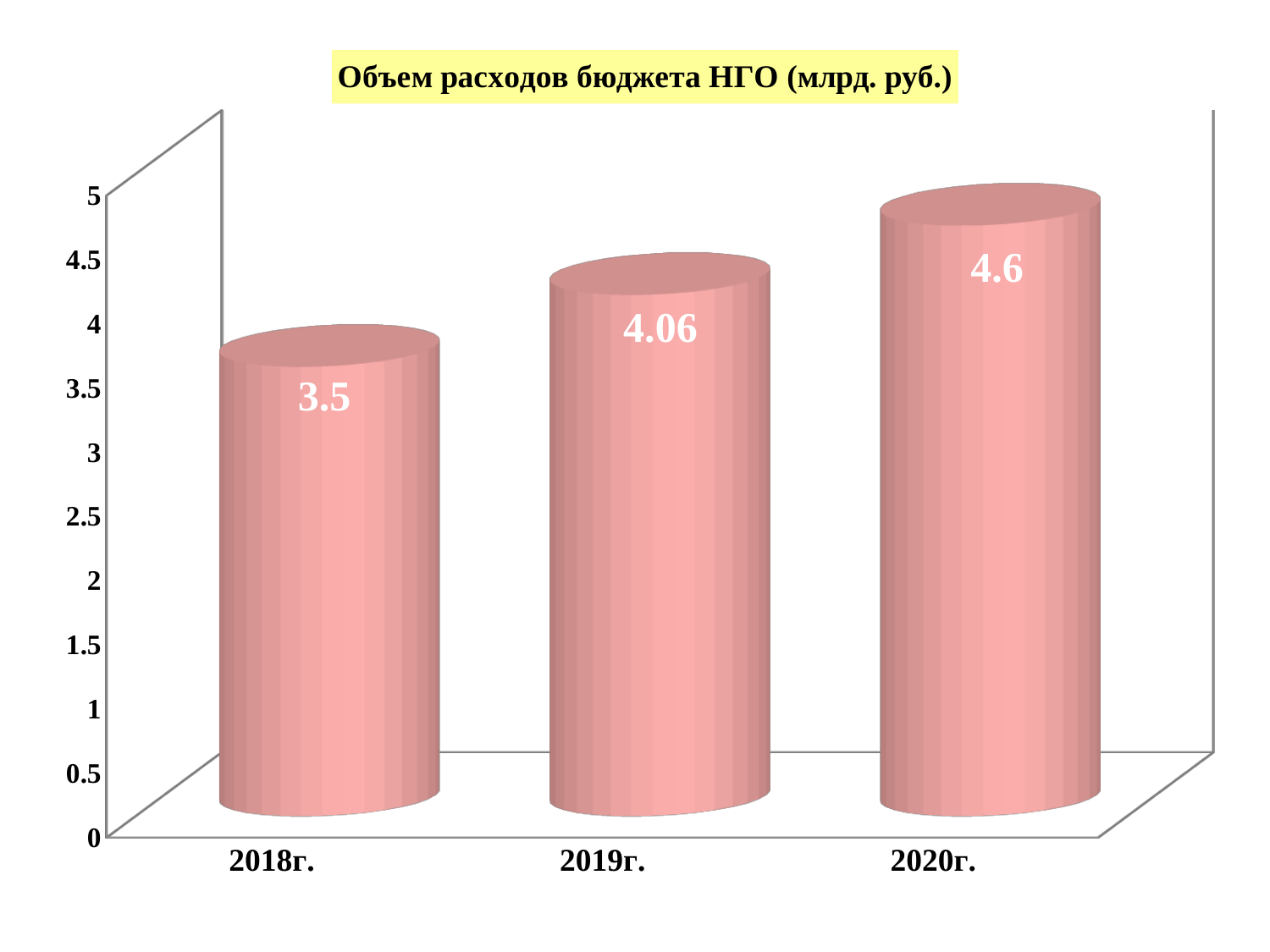
What is the value for 2018г.? 3.5 Is the value for 2018г. greater or less than 4? less What is the value for 2019г.? 4.06 How many years are shown on the chart? 3 Which is larger, the value for 2019г. or the value for 2020г.? 2020г. Which year has the highest value? 2020г. What is the value for 2020г.? 4.6 Do the values rise or fall from 2018г. to 2020г.? rise What kind of chart is shown on the slide? bar chart Which year has the lowest value? 2018г. What is the difference between the values for 2020г. and 2018г.? 1.1 What is the difference between the values for 2019г. and 2018г.? 0.56